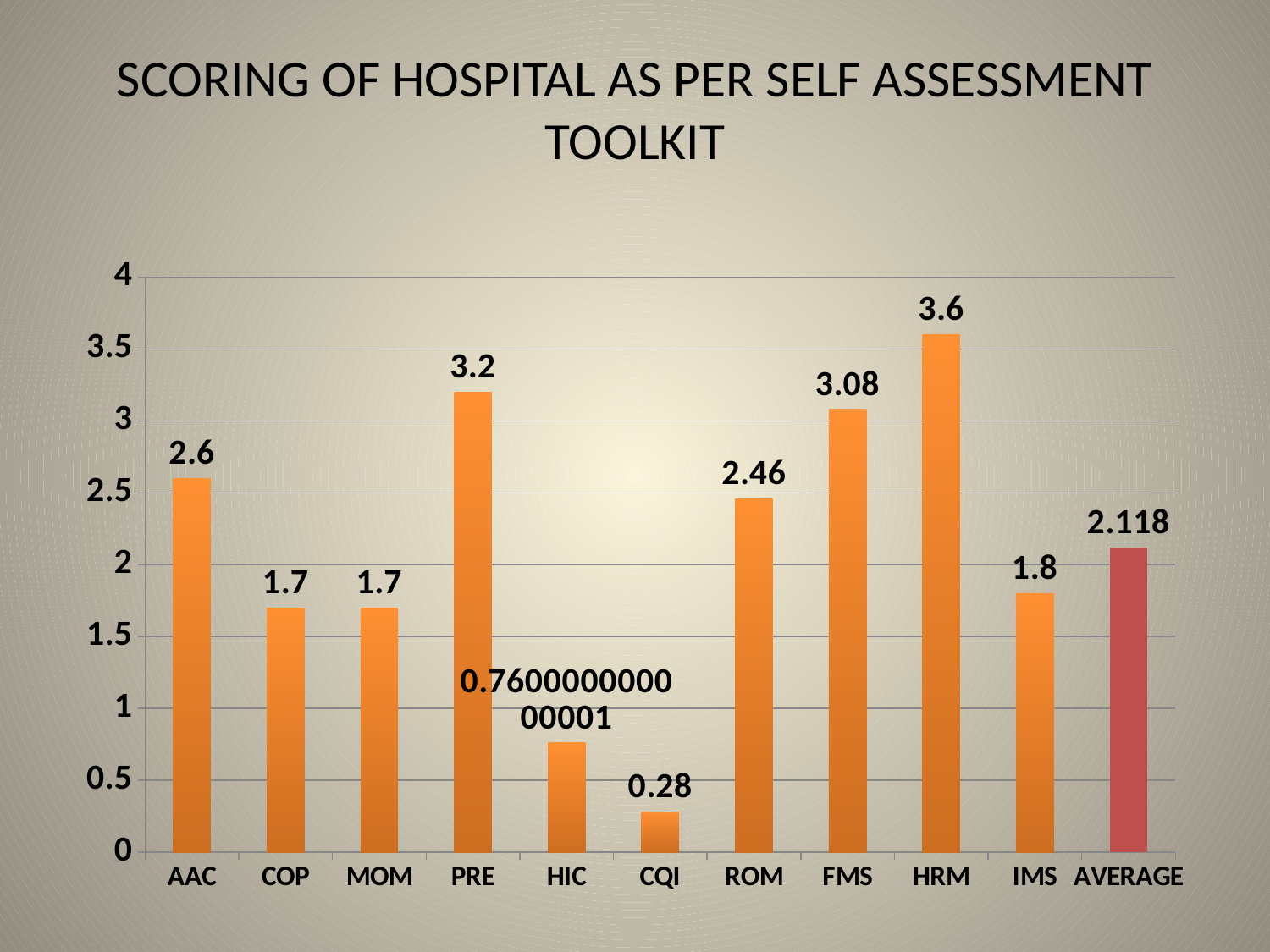
Which has a higher score, ROM or IMS? ROM What is the title of the chart? SCORING OF HOSPITAL AS PER SELF ASSESSMENT TOOLKIT How many categories are shown on the x axis? 11 Which category has the highest score? HRM Is the value for AAC greater or less than 2.5? greater What type of chart is shown on the slide? Bar chart What is the score for FMS? 3.08 What is the score for CQI? 0.28 What is the score for HRM? 3.6 Which category has the lowest score? CQI What is the difference between the scores for HRM and PRE? 0.4 What is the value shown for AVERAGE? 2.118